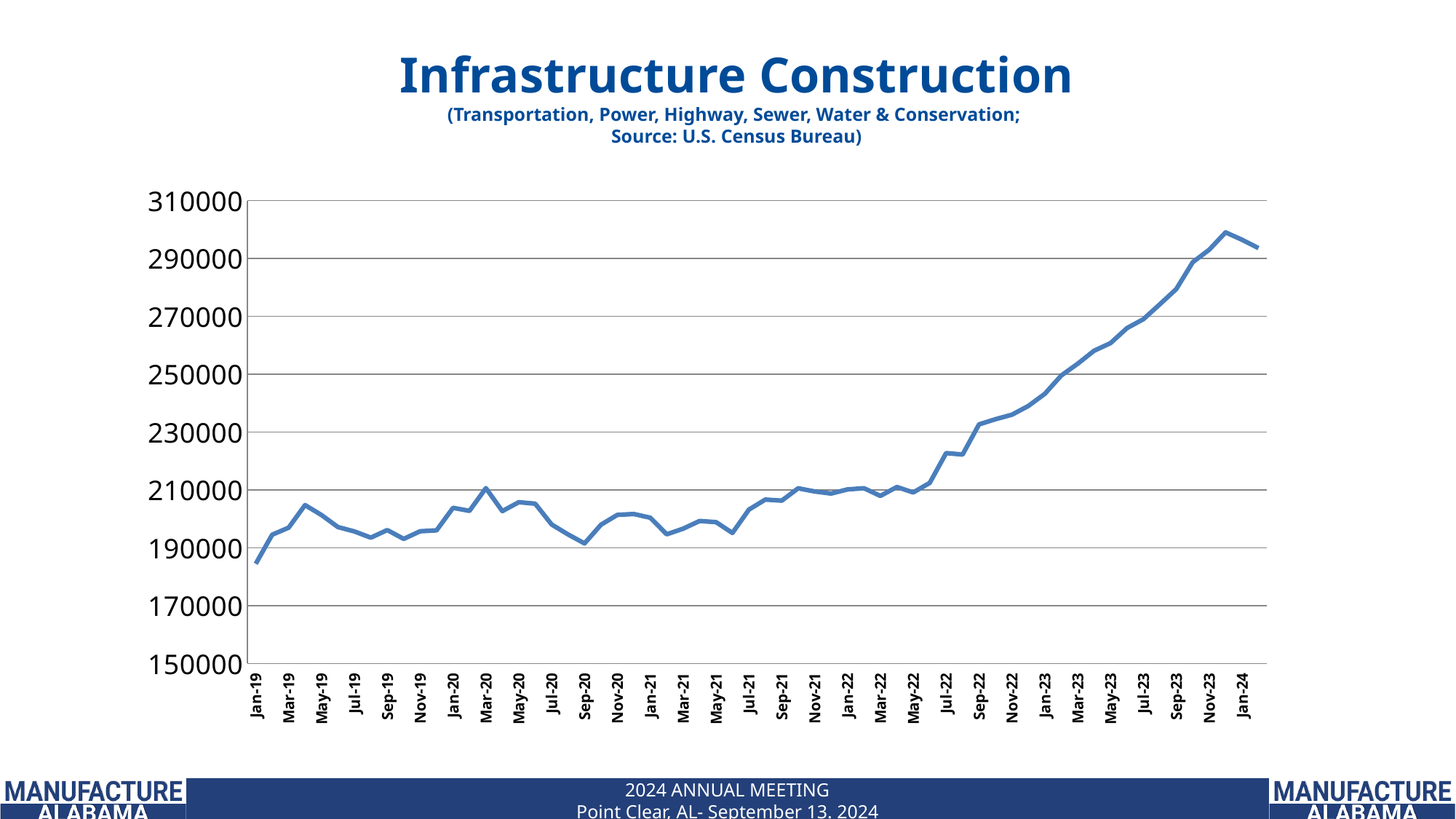
Which labelled month has the highest value on the chart? Jan-24 Which is larger, the value for Jan-24 or the value for Jan-19? Jan-24 What kind of chart is shown on the slide? line chart Is the value for Jan-19 greater or less than 190000? less Overall, do the values rise or fall from Jan-19 to Jan-24? rise According to the subtitle, what is the source of the data? U.S. Census Bureau Is the value for Jan-23 greater or less than 230000? greater Which is larger, the value for Nov-23 or the value for Sep-23? Nov-23 What is the title of the chart? Infrastructure Construction Which labelled month has the lowest value on the chart? Jan-19 Is the value for Jan-21 greater or less than 210000? less